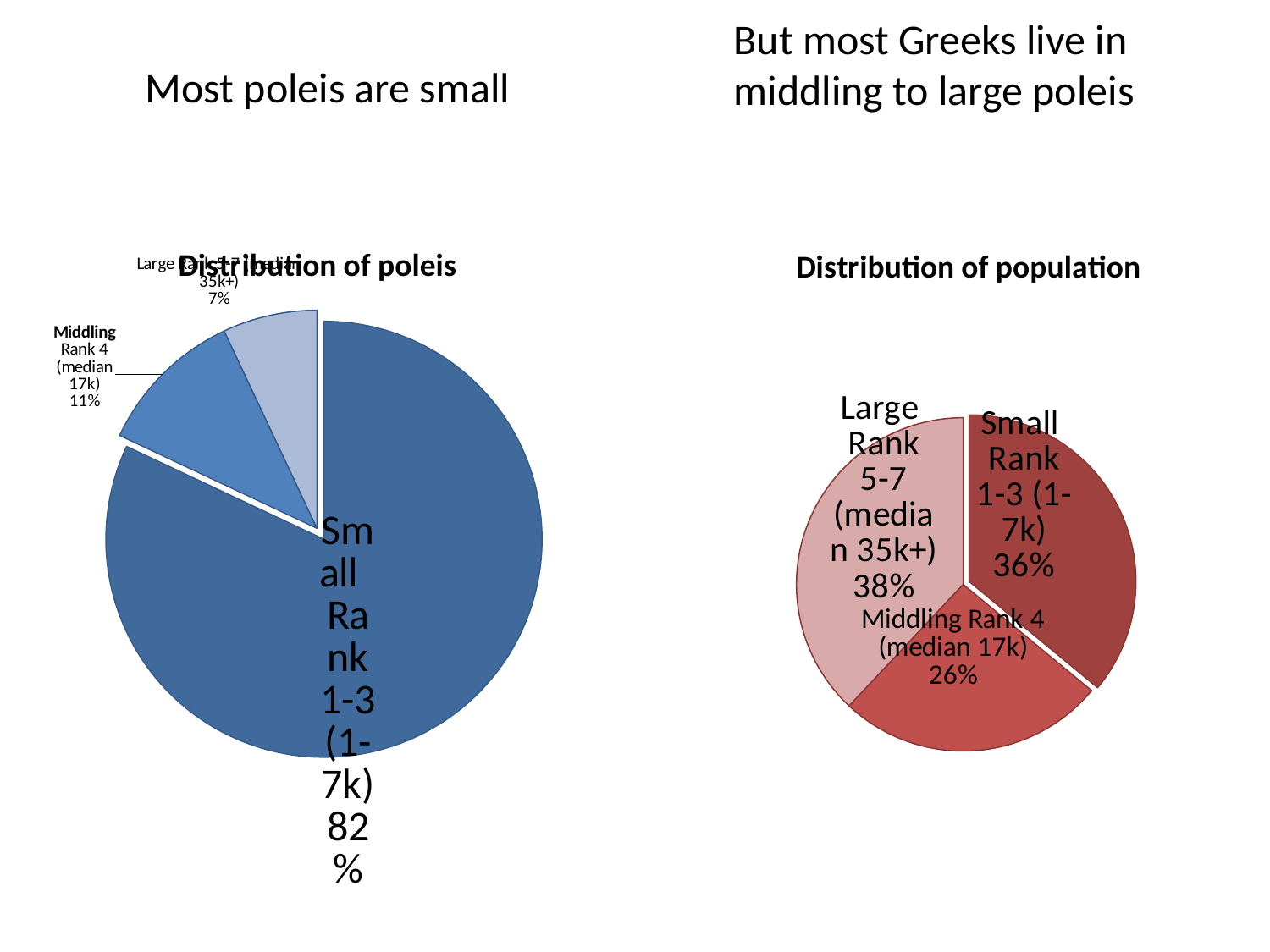
In the 'Distribution of population' chart, which category has the smallest slice? Middling Rank 4 (median 17k) In the 'Distribution of poleis' chart, what share of poleis are Middling (Rank 4)? 11% In the 'Distribution of population' chart, what share of the population lives in Large (Rank 5-7) poleis? 38% In the 'Distribution of poleis' chart, which category has the largest slice? Small Rank 1-3 (1-7k) In the 'Distribution of population' chart, what share of the population lives in Small (Rank 1-3) poleis? 36% In the 'Distribution of population' chart, what share of the population lives in Middling (Rank 4) poleis? 26% In the 'Distribution of poleis' chart, what share of poleis are Large (Rank 5-7)? 7% In the 'Distribution of poleis' chart, what share of poleis are Small (Rank 1-3)? 82% In the 'Distribution of poleis' chart, what is the difference in percentage points between the Small and Middling slices? 71 How many slices does the 'Distribution of population' chart have? 3 What type of chart is the 'Distribution of poleis' chart? Pie chart In the 'Distribution of population' chart, what is the difference in percentage points between the Large and Middling slices? 12